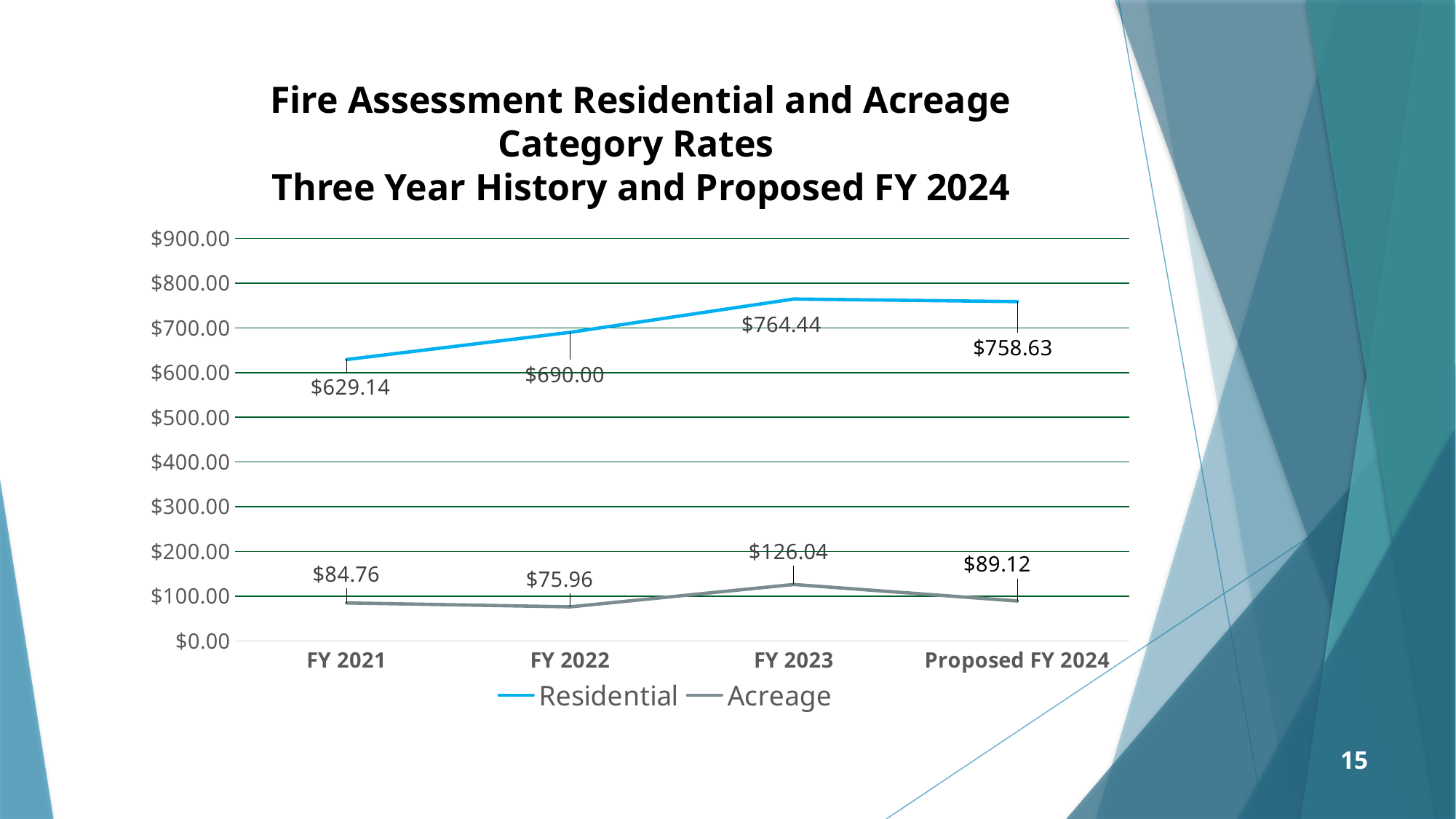
How many fiscal years are shown on the x axis? 4 Does the Residential rate rise or fall from FY 2021 to FY 2023? Rise How many series does the legend list? 2 What is the Residential rate for FY 2022? $690.00 What is the Acreage rate for FY 2021? $84.76 Which is larger, the Acreage rate for FY 2021 or for Proposed FY 2024? Proposed FY 2024 In which year is the Residential rate highest? FY 2023 What is the Acreage rate for FY 2023? $126.04 What is the Residential rate for Proposed FY 2024? $758.63 What is the difference between the Residential rate in FY 2022 and FY 2021? $60.86 What kind of chart is shown on the slide? Line chart In which year is the Acreage rate lowest? FY 2022